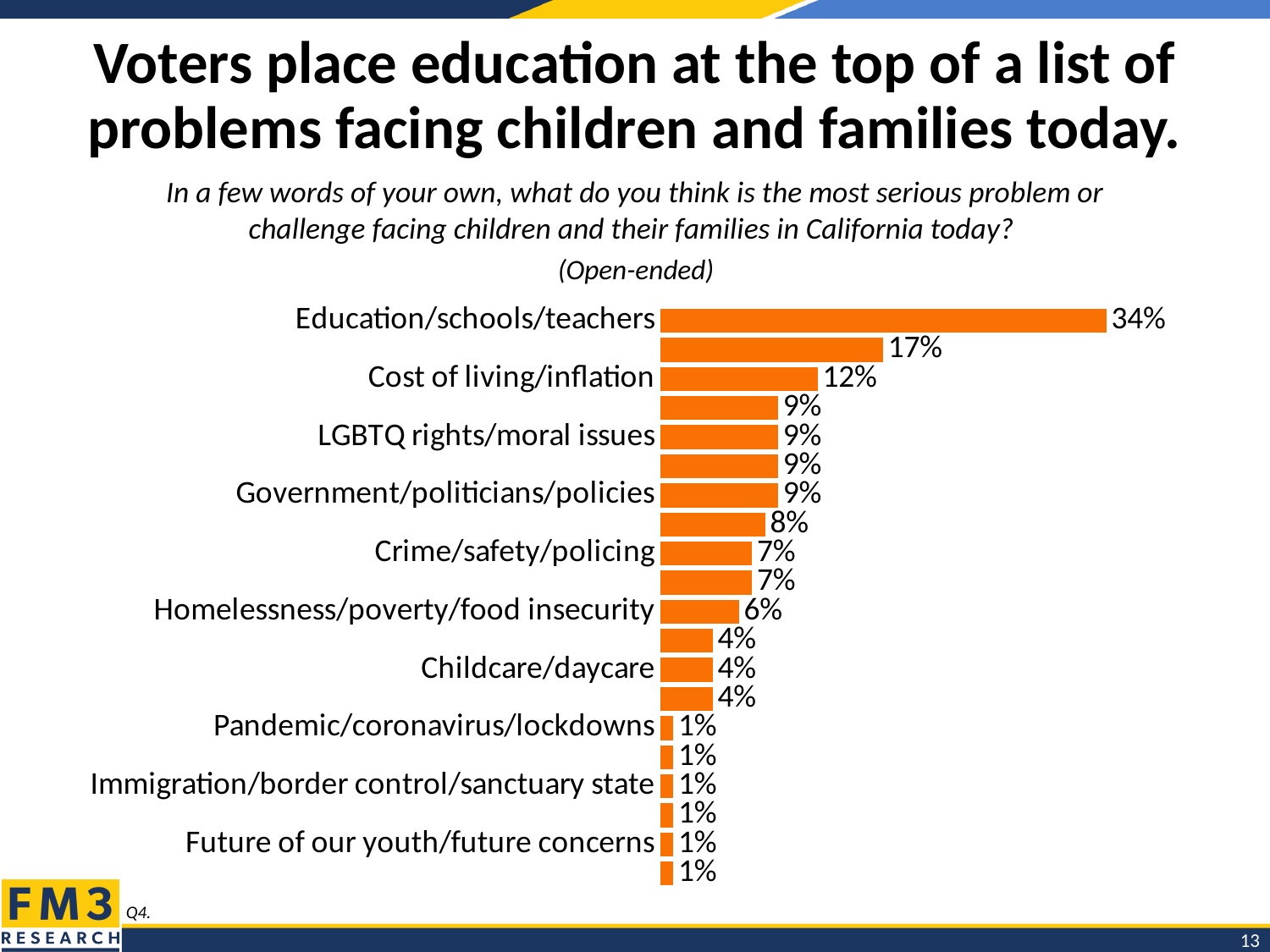
What percentage is shown for Crime/safety/policing? 7% Which is larger, the value for Crime/safety/policing or the value for Childcare/daycare? Crime/safety/policing What value is shown for Childcare/daycare? 4% Which category has the highest value in the chart? Education/schools/teachers What colour are the bars in the chart? Orange What percentage is shown for Homelessness/poverty/food insecurity? 6% What kind of chart is shown on the slide? Bar chart What percentage of voters named Education/schools/teachers as the most serious problem? 34% How many bars are plotted in the chart? 20 What is the difference in percentage points between Education/schools/teachers and Cost of living/inflation? 22 percentage points What is the difference in percentage points between Government/politicians/policies and Pandemic/coronavirus/lockdowns? 8 percentage points What value is shown for Cost of living/inflation? 12%